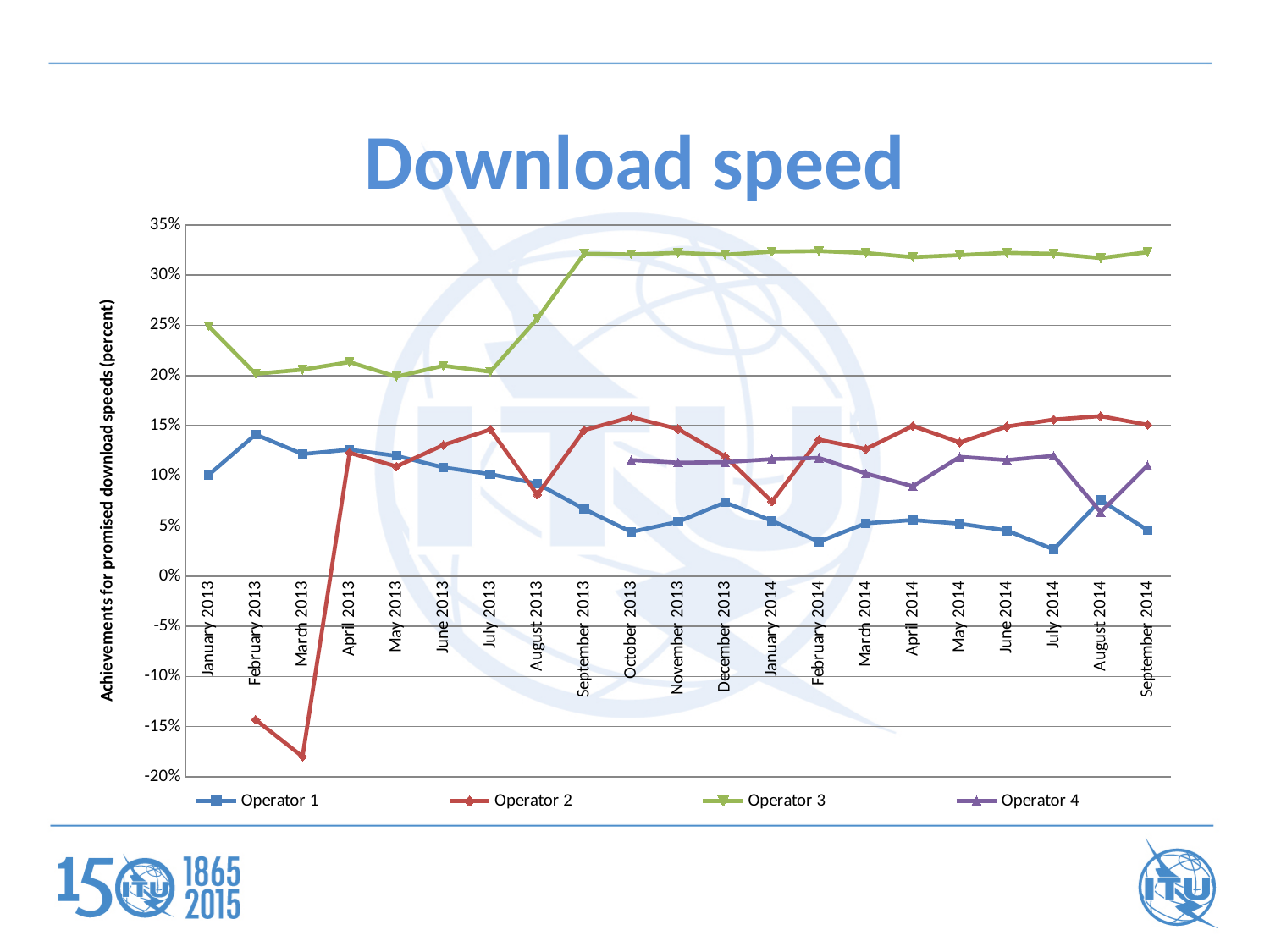
What kind of chart is shown on the slide? line chart How many series does the legend list? 4 Which operator has the lowest value in March 2013? Operator 2 In October 2013, which is larger: the value for Operator 1 or Operator 2? Operator 2 What is the title of the y axis? Achievements for promised download speeds (percent) Which operator has the highest value in September 2014? Operator 3 Is the value for Operator 3 in January 2013 greater or less than 20%? greater Is the value for Operator 1 in July 2014 greater or less than 5%? less Is the value for Operator 3 in September 2014 greater or less than 30%? greater How many months are shown along the x axis? 21 Does the value for Operator 3 rise or fall overall from January 2013 to September 2014? rise